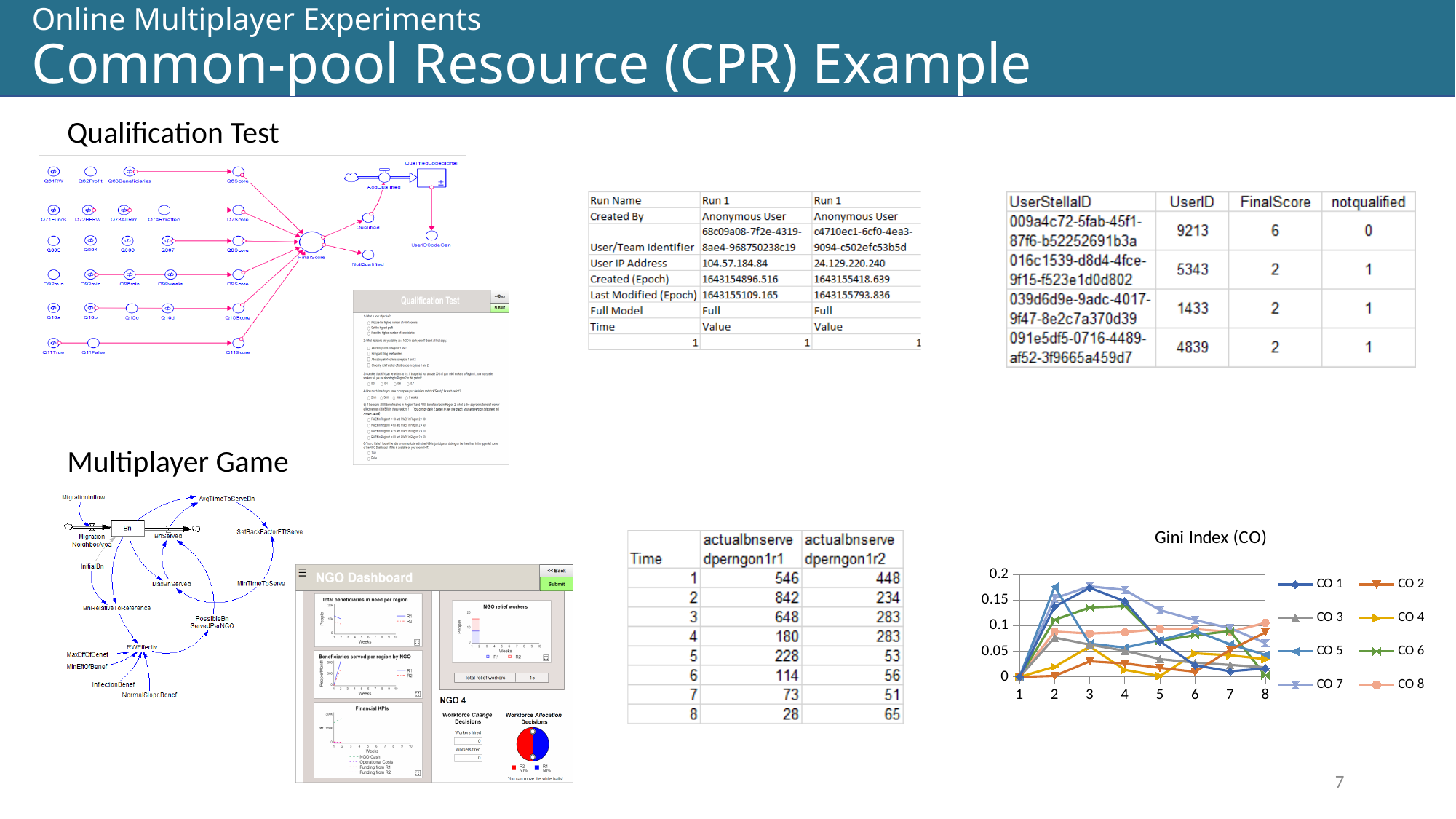
In the Gini Index (CO) chart, is the value for CO 2 at x = 8 greater or less than 0.05? greater In the Gini Index (CO) chart, is the value for CO 5 at x = 2 greater or less than 0.15? greater In the Gini Index (CO) chart, is the value for CO 1 at x = 3 greater or less than 0.15? greater What kind of chart is the Gini Index (CO) chart? line chart How many series does the legend of the Gini Index (CO) chart list? 8 How many points along the x axis does the Gini Index (CO) chart show for each series? 8 In the Gini Index (CO) chart, which is larger at x = 8: CO 8 or CO 3? CO 8 In the Gini Index (CO) chart, which is larger at x = 2: CO 5 or CO 3? CO 5 In the Gini Index (CO) chart, does the CO 1 series rise or fall from x = 3 to x = 8? fall What is the title of the line chart on the right of the slide? Gini Index (CO)